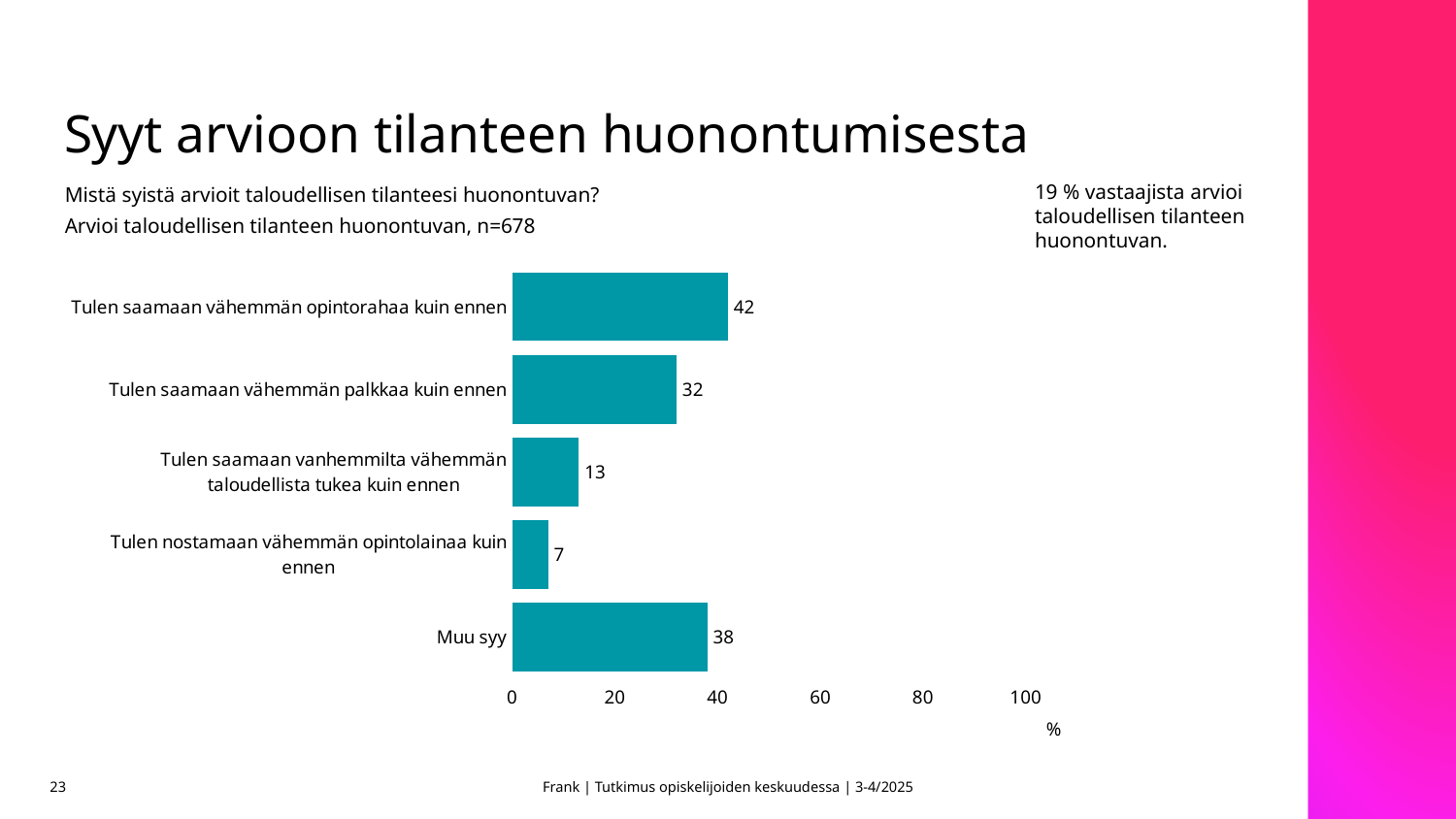
Which category has the highest value? Tulen saamaan vähemmän opintorahaa kuin ennen What is the value for "Tulen saamaan vähemmän palkkaa kuin ennen"? 32 How many categories are shown in the chart? 5 What is the value for "Tulen saamaan vähemmän opintorahaa kuin ennen"? 42 Which category has the lowest value? Tulen nostamaan vähemmän opintolainaa kuin ennen What is the sample size (n) stated above the chart? 678 Is the value for "Tulen saamaan vanhemmilta vähemmän taloudellista tukea kuin ennen" greater or less than 20? less What kind of chart is shown on the slide? bar chart What is the value for "Tulen nostamaan vähemmän opintolainaa kuin ennen"? 7 What is the value for "Muu syy"? 38 What is the difference between the values for "Tulen saamaan vähemmän opintorahaa kuin ennen" and "Tulen saamaan vähemmän palkkaa kuin ennen"? 10 Which is larger: the value for "Muu syy" or the value for "Tulen saamaan vähemmän palkkaa kuin ennen"? Muu syy